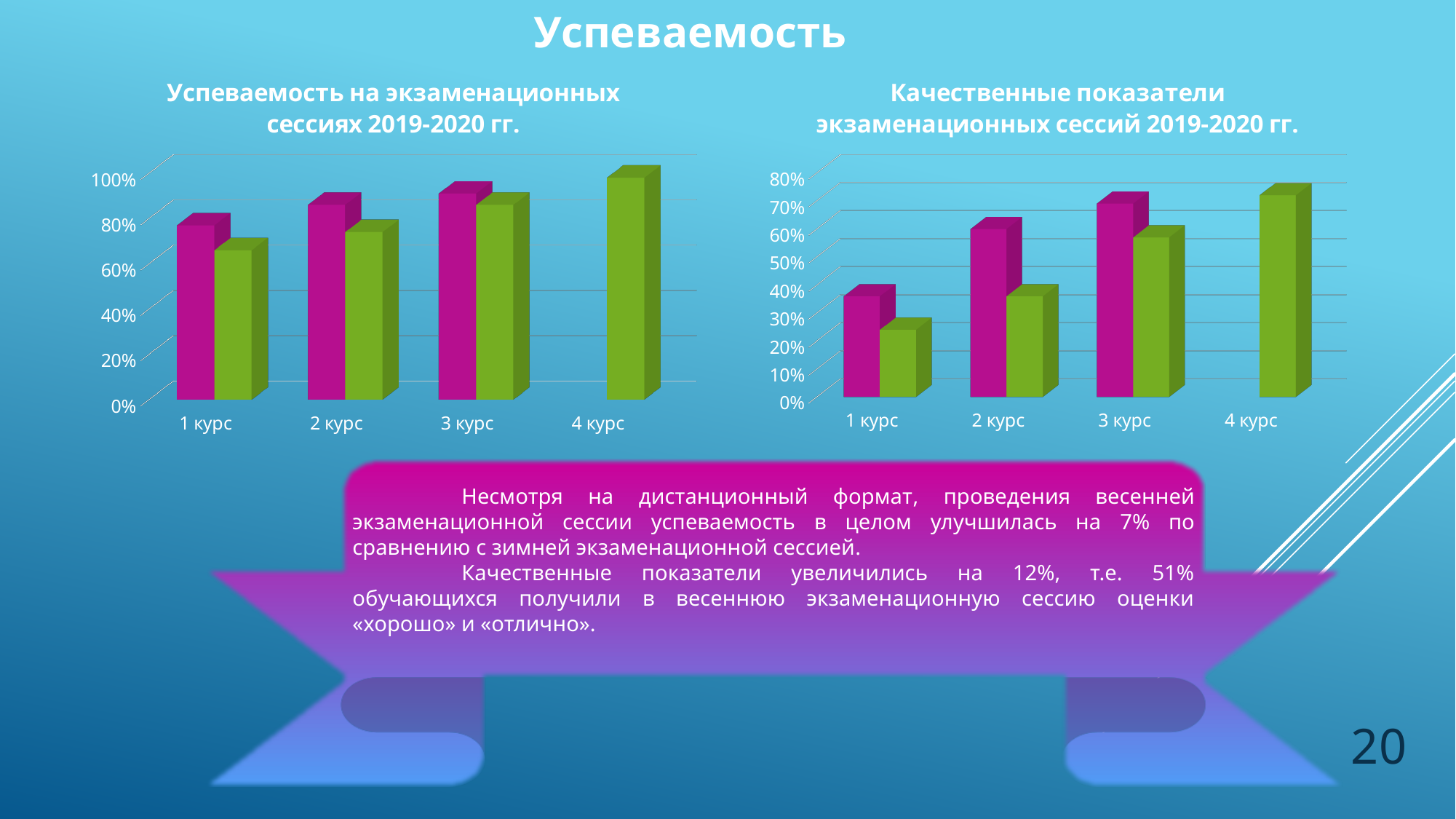
In the left chart, 'Успеваемость на экзаменационных сессиях 2019-2020 гг.', is the green bar for 4 курс greater or less than 80%? greater In the right chart, 'Качественные показатели экзаменационных сессий 2019-2020 гг.', which category has the lowest green bar? 1 курс In the right chart, 'Качественные показатели экзаменационных сессий 2019-2020 гг.', is the green bar for 1 курс greater or less than 30%? less In the right chart, 'Качественные показатели экзаменационных сессий 2019-2020 гг.', which is larger for 2 курс: the magenta bar or the green bar? the magenta bar In the left chart, 'Успеваемость на экзаменационных сессиях 2019-2020 гг.', which category has the lowest green bar? 1 курс In the left chart, 'Успеваемость на экзаменационных сессиях 2019-2020 гг.', which category has the highest green bar? 4 курс What is the title of the chart on the right side of the slide? Качественные показатели экзаменационных сессий 2019-2020 гг. In the right chart, 'Качественные показатели экзаменационных сессий 2019-2020 гг.', is the magenta bar for 3 курс greater or less than 60%? greater What kind of chart is the left chart, 'Успеваемость на экзаменационных сессиях 2019-2020 гг.'? bar chart How many categories are shown on the x axis of the right chart, 'Качественные показатели экзаменационных сессий 2019-2020 гг.'? 4 In the left chart, 'Успеваемость на экзаменационных сессиях 2019-2020 гг.', do the green bars rise or fall from 1 курс to 4 курс? rise